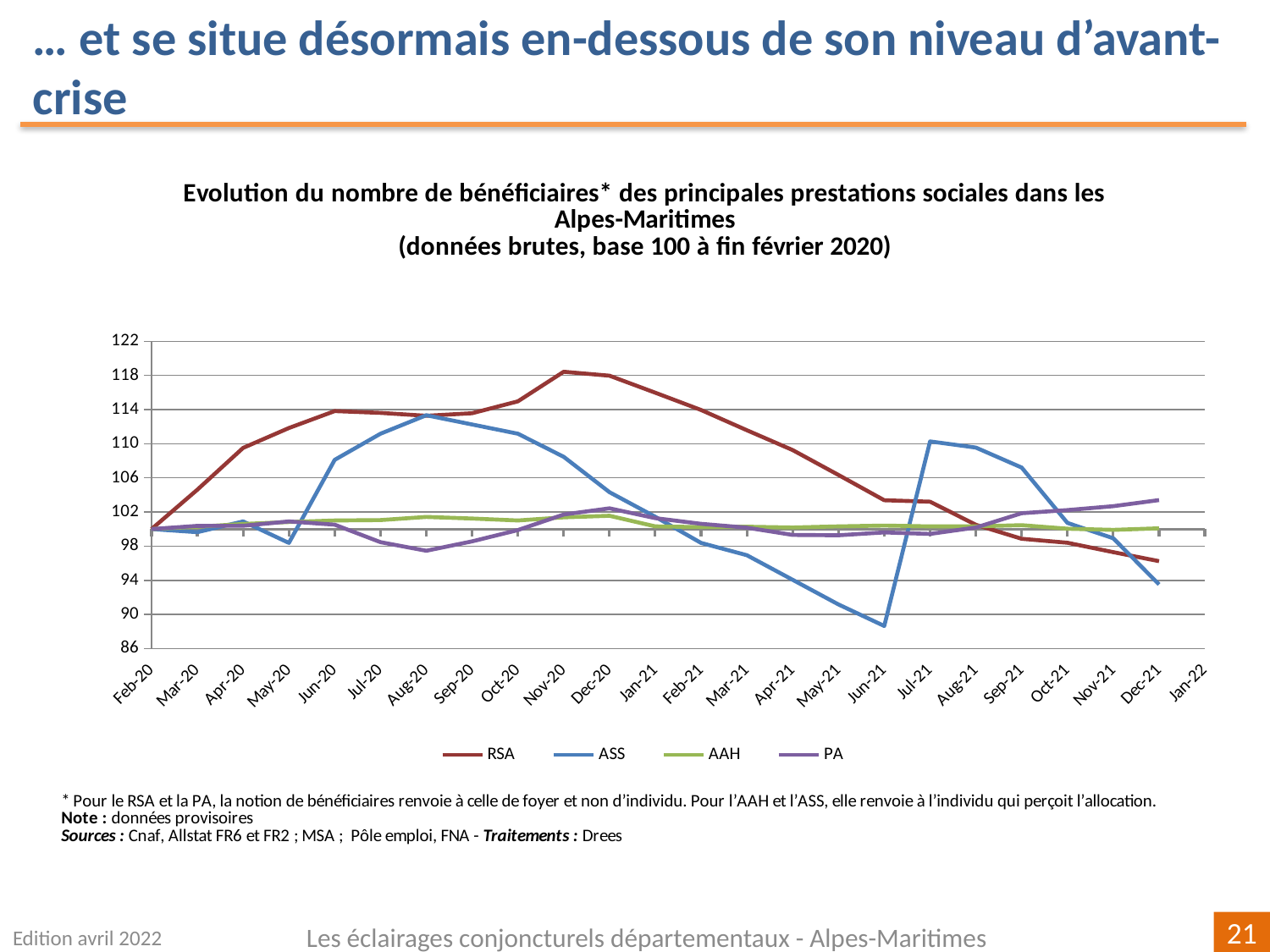
Is the value for ASS in Jun-21 greater or less than 90? less Is the value for RSA in Dec-21 greater or less than 98? less How many month labels are shown on the x axis, from Feb-20 to Jan-22? 24 How many series does the legend list? 4 Is the value for PA in Dec-21 greater or less than 102? greater Does the RSA series rise or fall between Nov-20 and Dec-21? fall Which series is drawn in purple in the legend? PA Which series falls to the lowest value on the chart? ASS Which series reaches the highest value on the chart? RSA In Jun-21, which is larger, the value for RSA or the value for ASS? RSA What kind of chart is shown on the slide? line chart